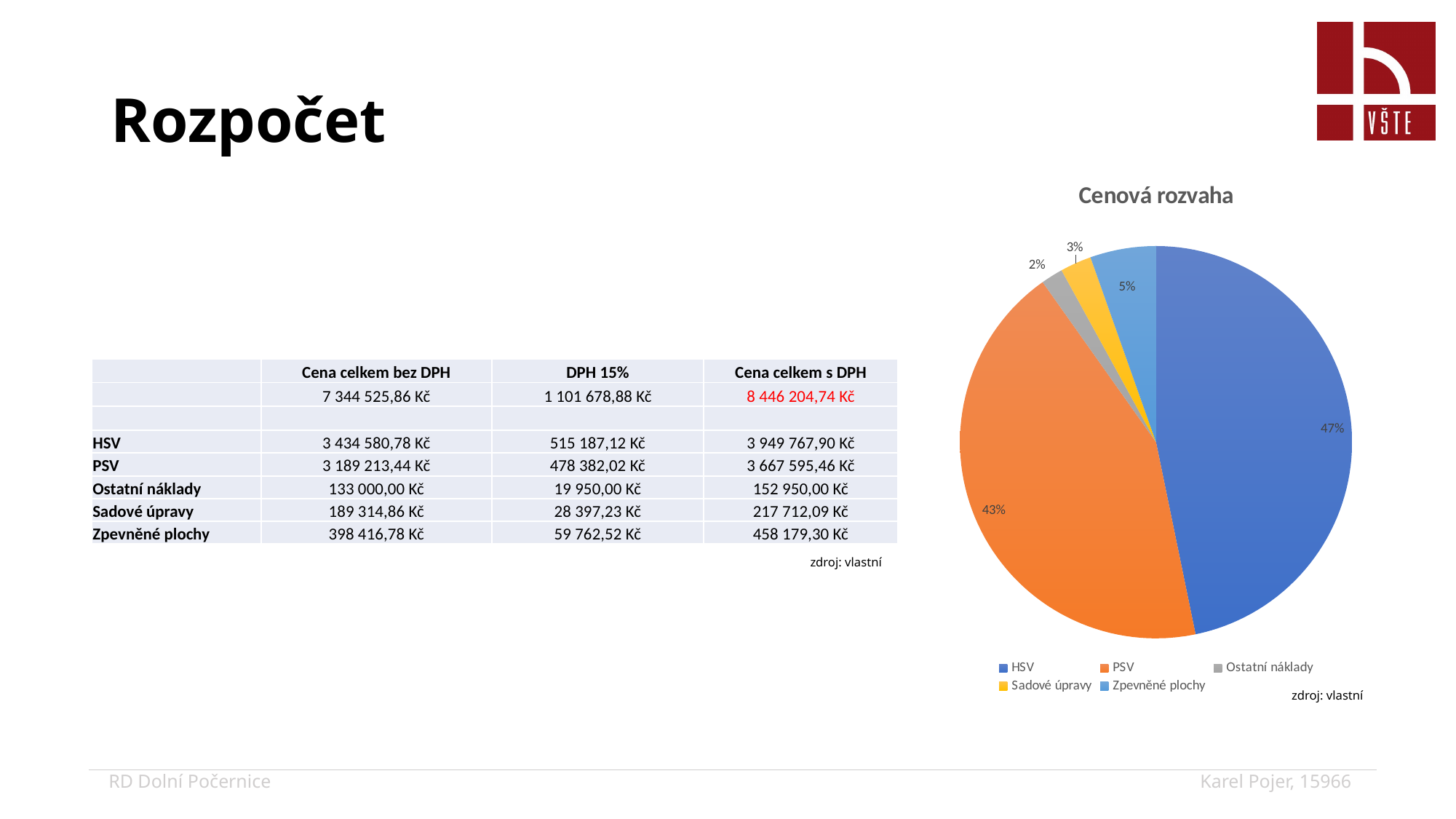
What share of the pie does Zpevněné plochy represent? 5% Which category has the largest slice of the pie? HSV How many slices does the pie chart have? 5 What is the difference in percentage points between the HSV and PSV slices? 4 Which category has the smallest slice of the pie? Ostatní náklady What is the title of the chart? Cenová rozvaha What share of the pie does Ostatní náklady represent? 2% What share of the pie does HSV represent? 47% What type of chart is shown on the slide? pie chart Which slice is larger, Zpevněné plochy or Sadové úpravy? Zpevněné plochy